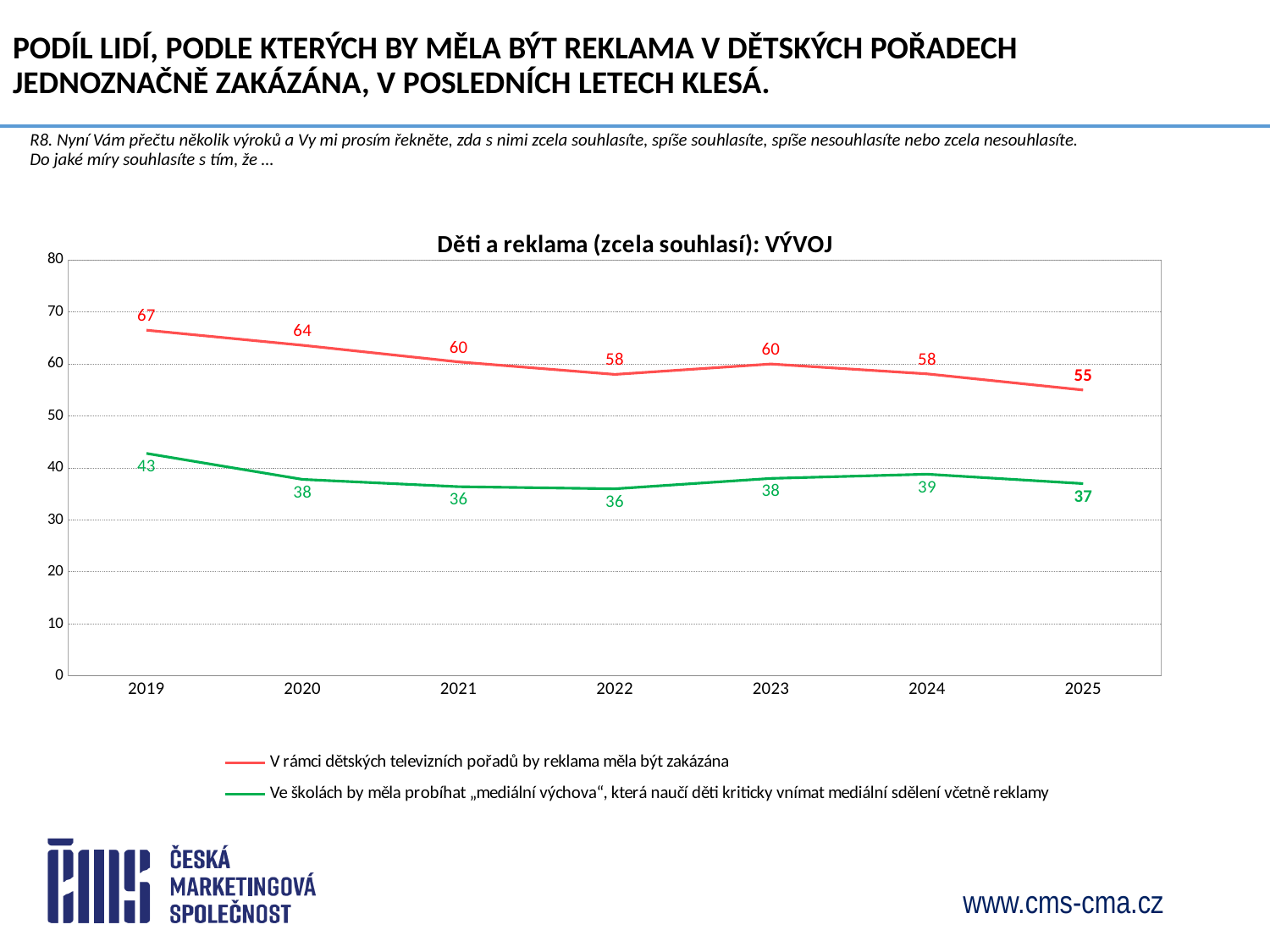
In which year is the green series (mediální výchova) highest? 2019 What is the value of the green series (Ve školách by měla probíhat „mediální výchova“) in 2024? 39 What is the title of the chart? Děti a reklama (zcela souhlasí): VÝVOJ What is the value of the red series in 2025? 55 By how much did the red series fall from 2019 to 2025? 12 How many series does the legend list? 2 Which series has the higher value in 2022, the red or the green? red (V rámci dětských televizních pořadů by reklama měla být zakázána) In which year is the red series (reklama by měla být zakázána) highest? 2019 What is the difference between the red and green series values in 2019? 24 How many years are shown on the x axis? 7 What kind of chart is shown? line chart What is the value of the red series (V rámci dětských televizních pořadů by reklama měla být zakázána) in 2019? 67